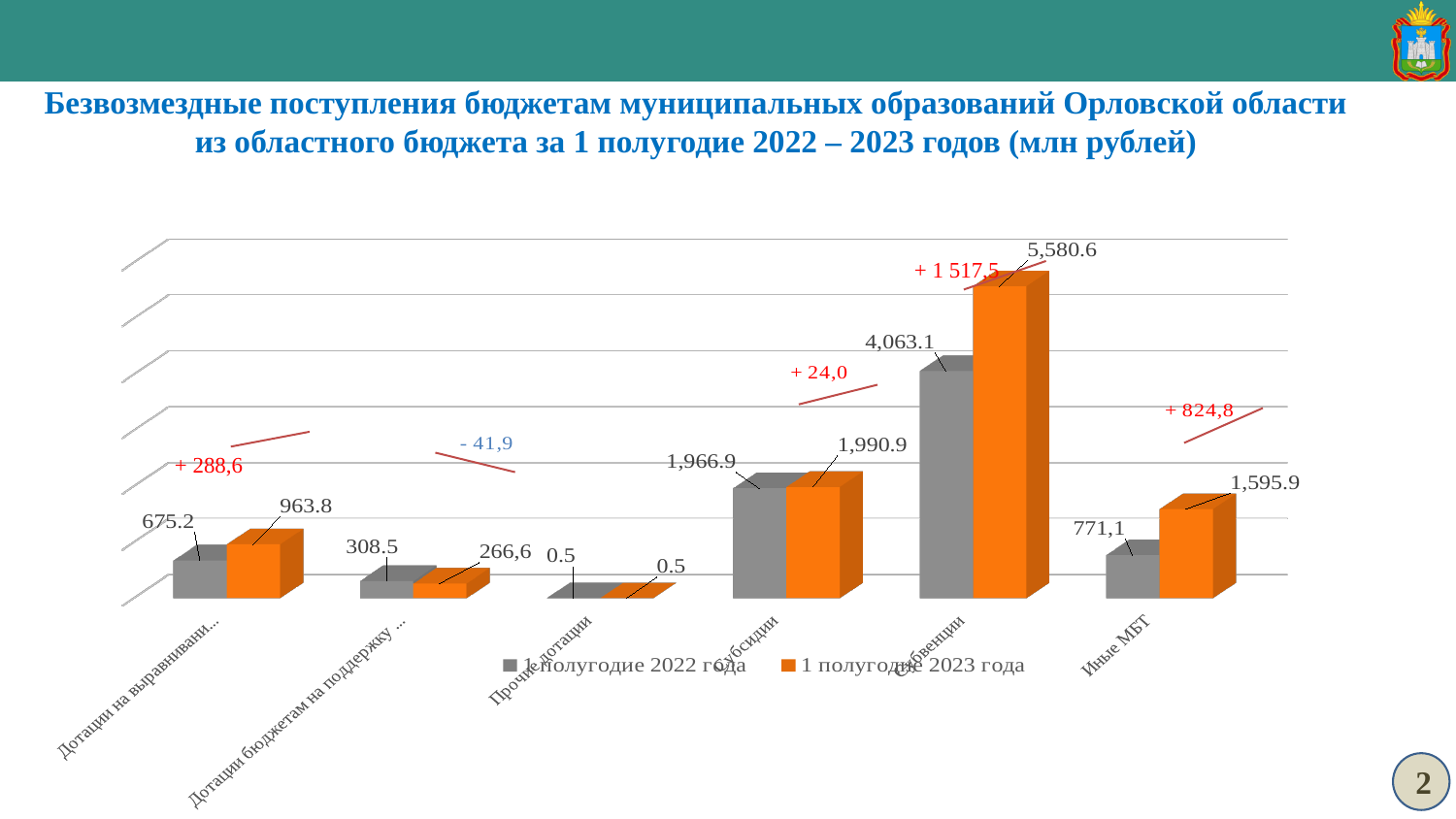
What is the value for Иные МБТ in the 1 полугодие 2023 года series? 1,595.9 What is the value for Субвенции in the 1 полугодие 2023 года series? 5,580.6 Which category has the lowest value in the 1 полугодие 2022 года series? Прочие дотации By how much did the value for Субвенции increase from 1 полугодие 2022 года to 1 полугодие 2023 года? 1 517,5 Which series is shown in orange in the chart? 1 полугодие 2023 года How many series does the legend list? 2 What is the value for Иные МБТ in the 1 полугодие 2022 года series? 771,1 Which is larger in the 1 полугодие 2023 года series: Субсидии or Иные МБТ? Субсидии Which category has the highest value in the 1 полугодие 2023 года series? Субвенции What kind of chart is shown on the slide? Bar chart How many categories are shown on the x axis of the chart? 6 What is the value for Субсидии in the 1 полугодие 2022 года series? 1,966.9